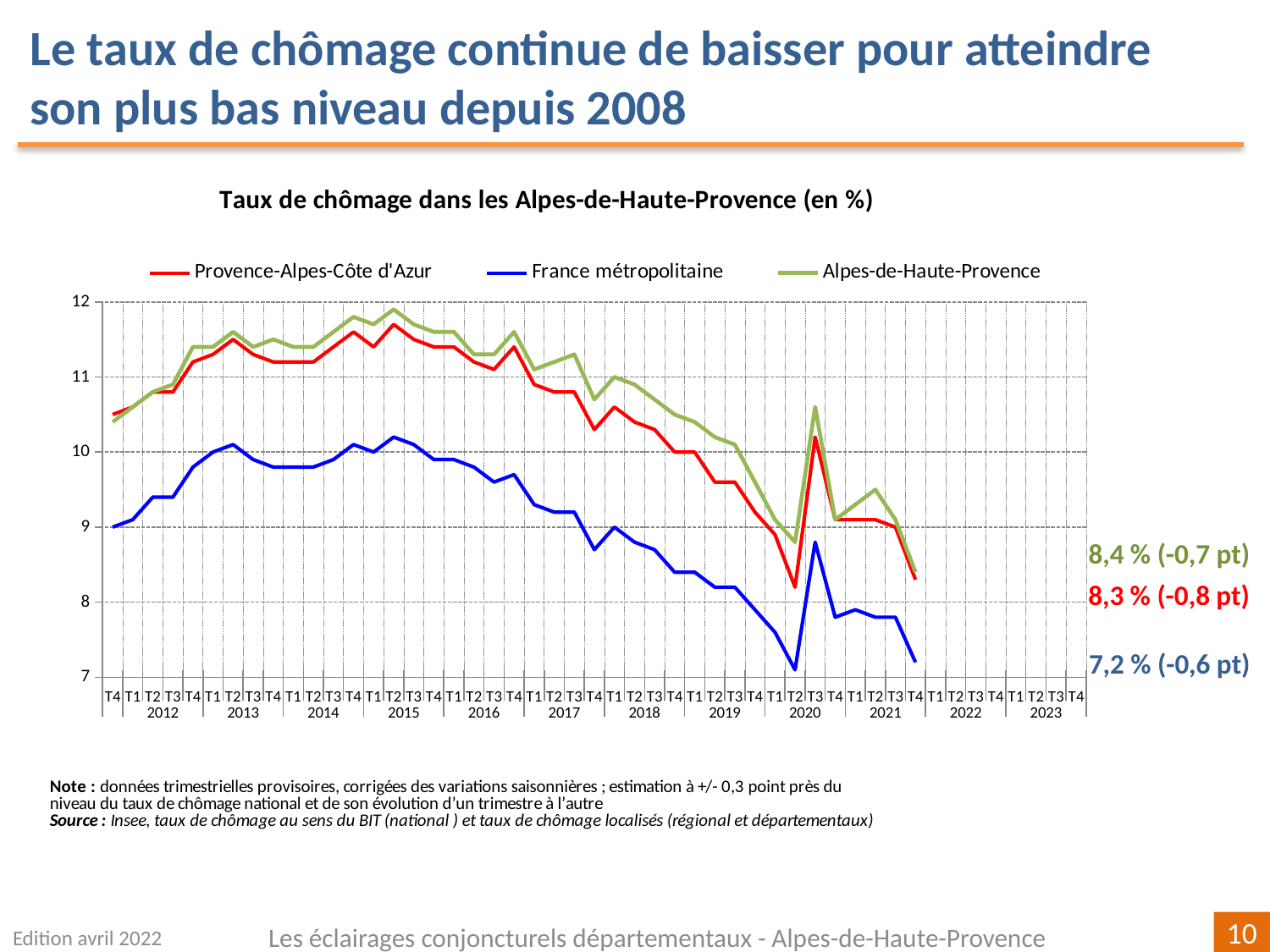
At T4 2021, which is higher: Alpes-de-Haute-Provence or France métropolitaine? Alpes-de-Haute-Provence Which series has the lowest value at T4 2021? France métropolitaine Is the value for Alpes-de-Haute-Provence at T2 2015 greater or less than 11? greater What is the unemployment rate shown for Alpes-de-Haute-Provence at the end of the series (T4 2021)? 8,4 % What kind of chart is shown on the slide? line chart How many series does the legend list? 3 What is the unemployment rate shown for Provence-Alpes-Côte d'Azur at the end of the series (T4 2021)? 8,3 % What is the difference between the final values for Alpes-de-Haute-Provence and France métropolitaine? 1,2 points What is the unemployment rate shown for France métropolitaine at the end of the series (T4 2021)? 7,2 % Between 2016 and 2019, does the France métropolitaine line generally rise or fall? fall What is the quarterly change shown next to the final value for France métropolitaine? -0,6 pt Is the value for France métropolitaine at T4 2011 greater or less than 10? less